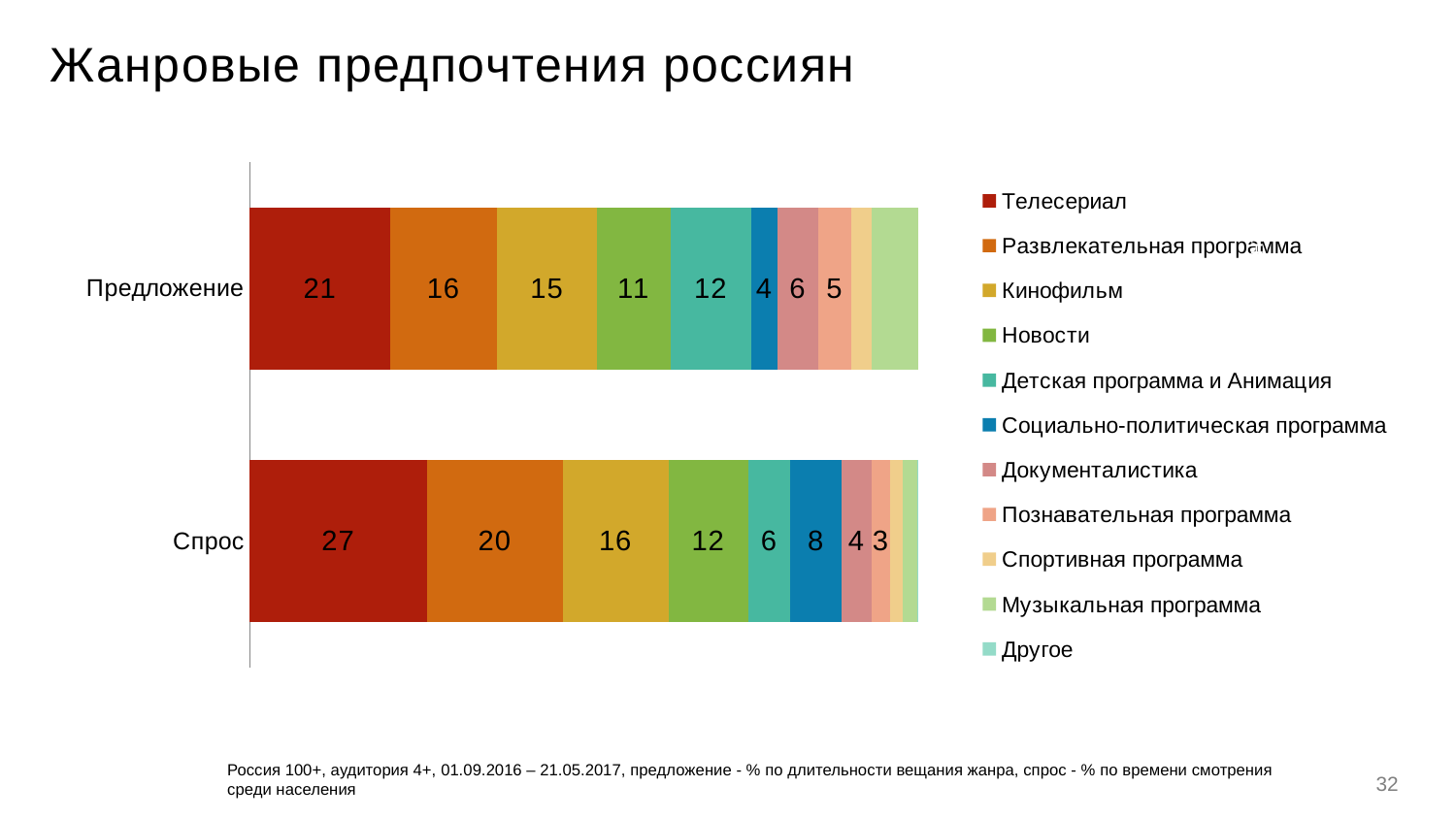
Which genre has the largest segment in the Спрос bar? Телесериал Which is larger: Детская программа и Анимация in Предложение or in Спрос? Предложение What is the value for Телесериал in the Предложение bar? 21 What is the title of the chart on the slide? Жанровые предпочтения россиян How many series does the legend list? 11 How many bars (categories) are plotted in the chart? 2 What is the value for Детская программа и Анимация in the Предложение bar? 12 What is the value for Телесериал in the Спрос bar? 27 What kind of chart is shown on the slide? Stacked bar chart What is the value for Социально-политическая программа in the Спрос bar? 8 What is the difference between the Телесериал values for Спрос and Предложение? 6 What is the value for Развлекательная программа in the Спрос bar? 20